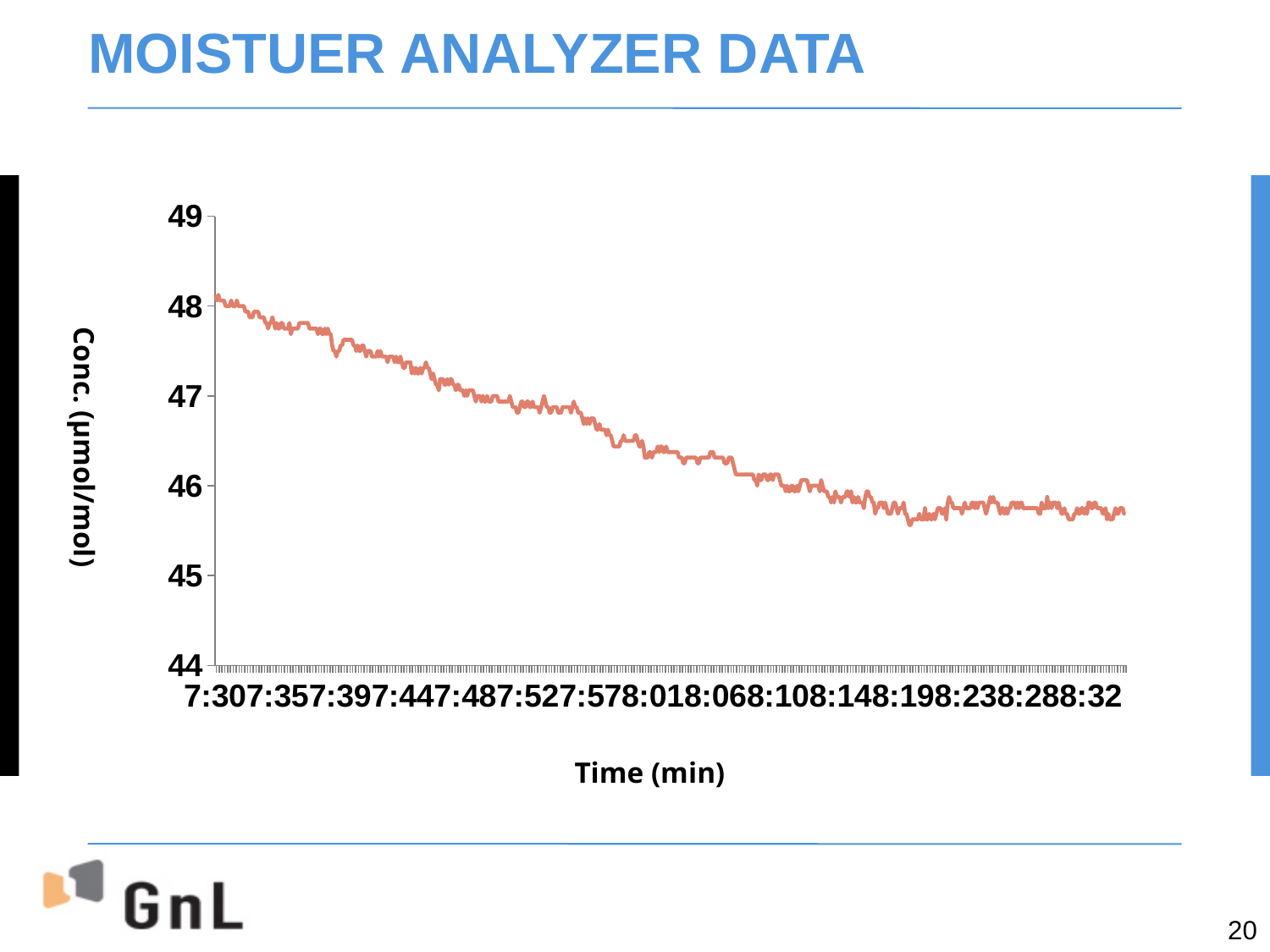
What kind of chart is shown on the slide? line chart Which time has the higher concentration, 7:30 or 8:32? 7:30 Is the concentration at 8:32 greater or less than 46? less Does the concentration rise or fall over time along the x axis? fall Is the concentration at 8:32 greater or less than 45? greater How many time labels are shown on the x axis? 15 What is the highest value shown on the y axis? 49 What is the label of the y axis? Conc. (µmol/mol) Is the concentration at 8:01 greater or less than 47? less What is the title of the slide's chart? MOISTUER ANALYZER DATA